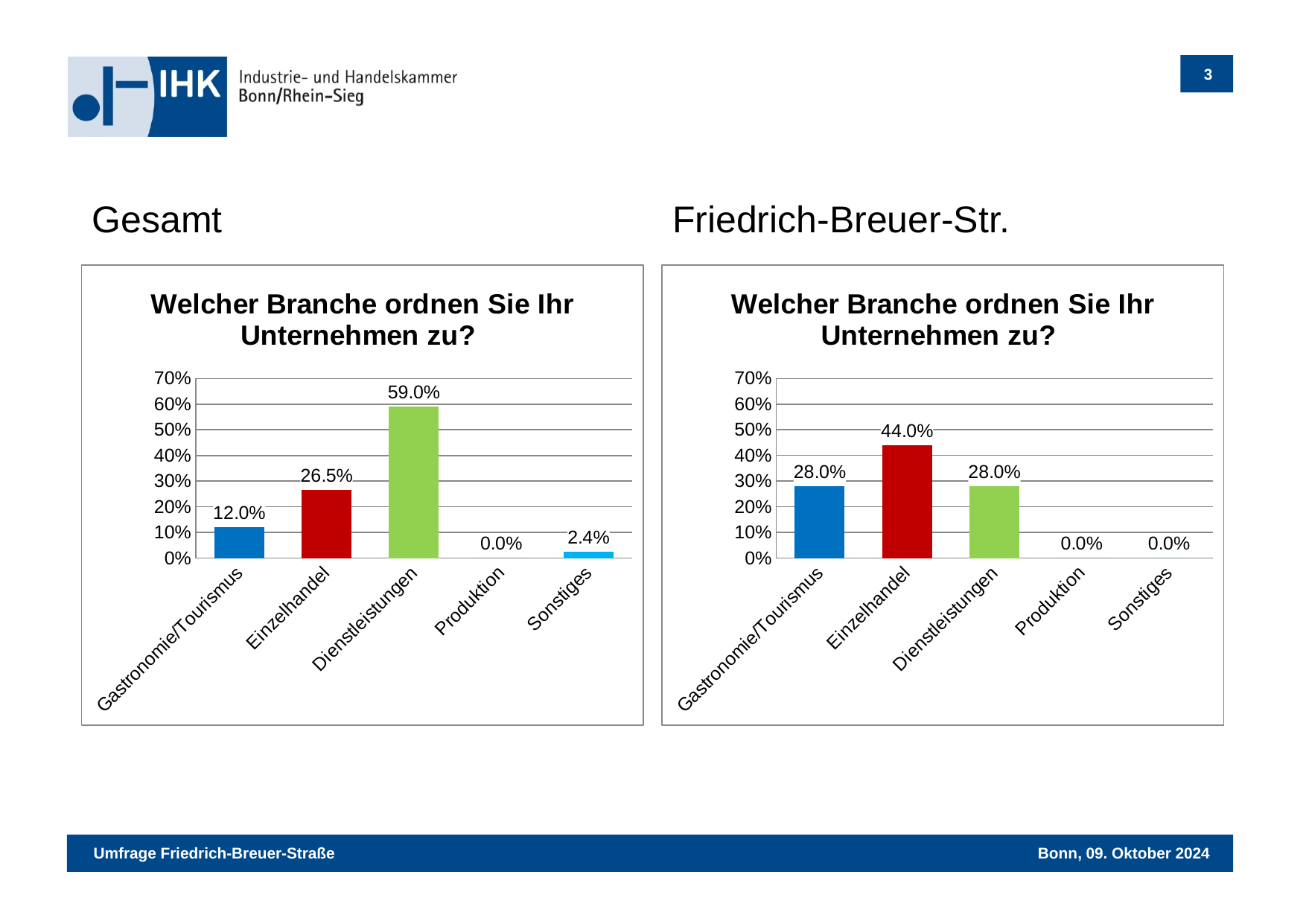
In the 'Friedrich-Breuer-Str.' chart on the right, is the value for Einzelhandel greater or less than 40%? greater In the 'Gesamt' chart on the left, what is the difference between Dienstleistungen and Einzelhandel? 32.5% What is the title of the 'Gesamt' chart on the left? Welcher Branche ordnen Sie Ihr Unternehmen zu? In the 'Gesamt' chart on the left, what is the value for Sonstiges? 2.4% In the 'Gesamt' chart on the left, which is larger: Gastronomie/Tourismus or Einzelhandel? Einzelhandel In the 'Friedrich-Breuer-Str.' chart on the right, which category has the highest value? Einzelhandel In the 'Friedrich-Breuer-Str.' chart on the right, what is the difference between Einzelhandel and Gastronomie/Tourismus? 16.0% In the 'Gesamt' chart on the left, which category has the highest value? Dienstleistungen In the 'Friedrich-Breuer-Str.' chart on the right, what is the value for Einzelhandel? 44.0% How many categories are shown on the x axis of the 'Gesamt' chart on the left? 5 What kind of chart is the 'Friedrich-Breuer-Str.' chart on the right? bar chart In the 'Gesamt' chart on the left, what is the value for Dienstleistungen? 59.0%